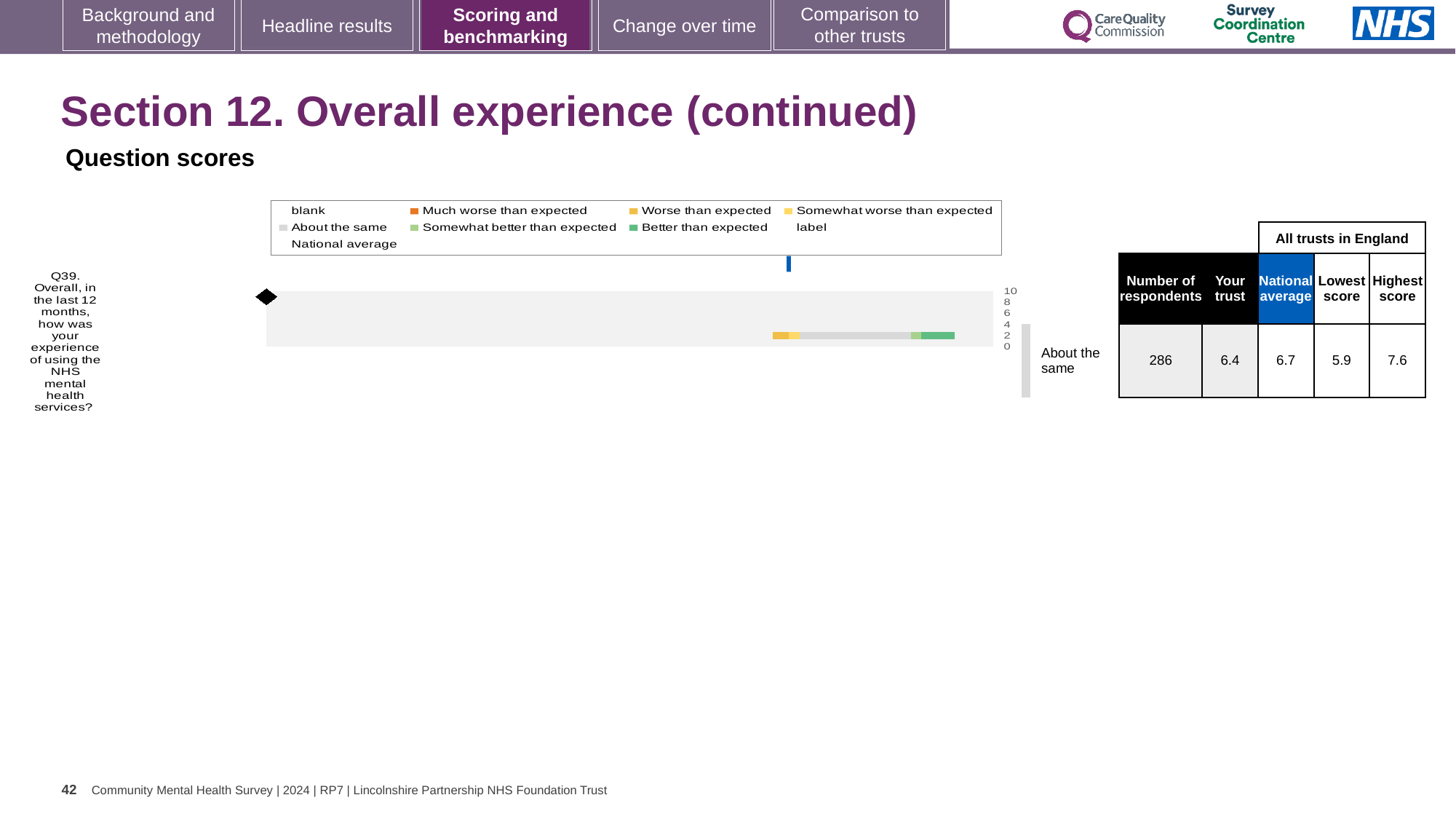
What kind of chart is shown on the slide? bar chart How many survey questions are plotted on the chart? 1 What is the difference between the highest and lowest scores for Q39? 1.7 What is the 'Your trust' score for Q39? 6.4 How many respondents answered Q39? 286 What is the difference between the national average and the 'Your trust' score for Q39? 0.3 Which is larger for Q39: the 'Your trust' score or the national average? National average What is the highest score among all trusts in England for Q39? 7.6 What benchmark category is the trust's Q39 score labelled as? About the same Is the 'Your trust' score for Q39 greater or less than 8? less What is the national average score for Q39? 6.7 What is the lowest score among all trusts in England for Q39? 5.9